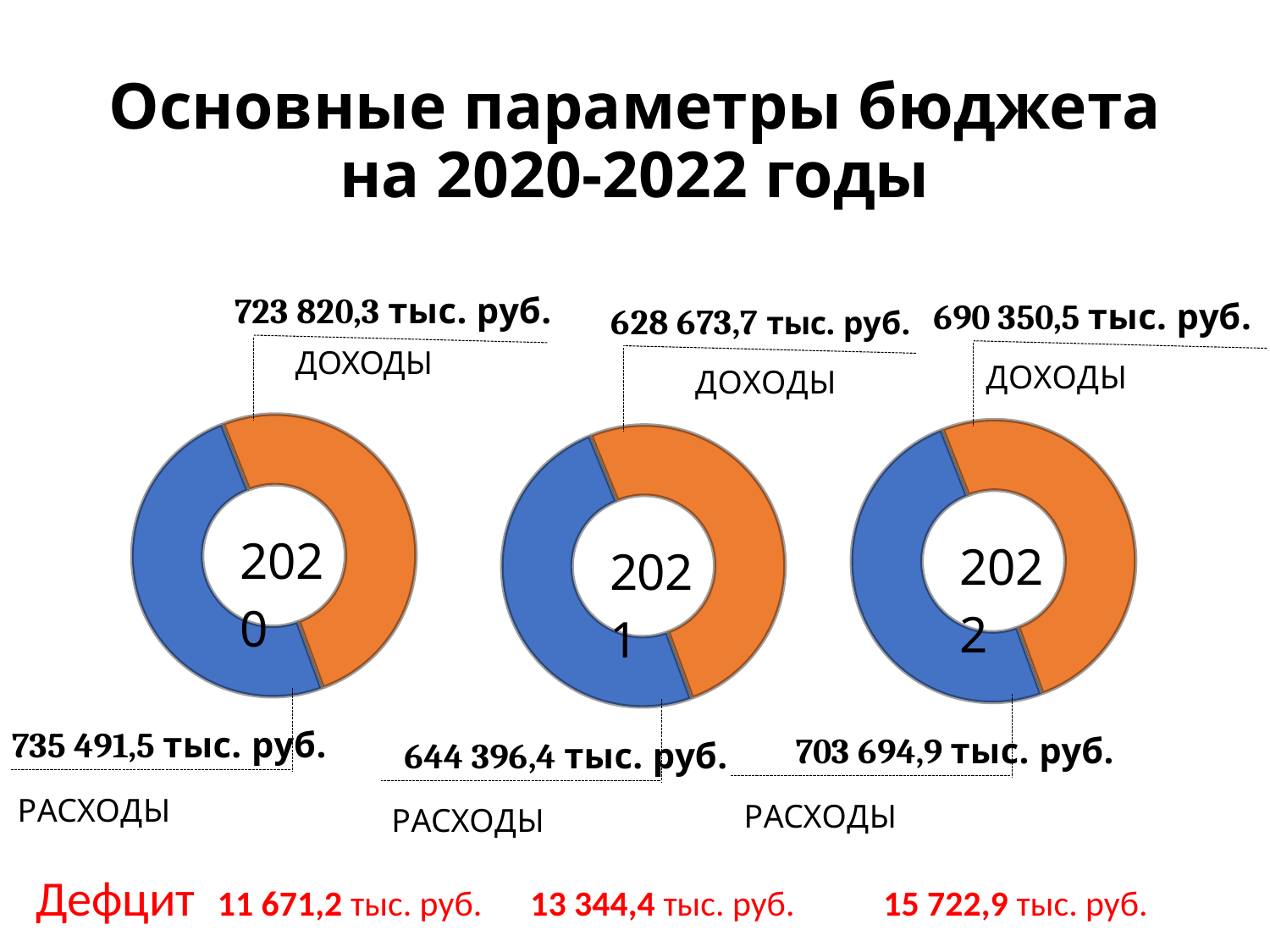
In the 2020 doughnut chart, which is larger, ДОХОДЫ or РАСХОДЫ? РАСХОДЫ What type of chart is used for each year on the slide? Doughnut chart How many doughnut charts are shown on the slide? 3 In the 2020 doughnut chart, what is the value for РАСХОДЫ? 735 491,5 тыс. руб. In the 2021 doughnut chart, which colour represents ДОХОДЫ? Orange In the 2022 doughnut chart, what is the value for РАСХОДЫ? 703 694,9 тыс. руб. In the 2020 doughnut chart, what is the value for ДОХОДЫ? 723 820,3 тыс. руб. In the 2022 doughnut chart, what is the difference between РАСХОДЫ and ДОХОДЫ? 13 344,4 тыс. руб. In the 2021 doughnut chart, what is the value for РАСХОДЫ? 644 396,4 тыс. руб. In the 2021 doughnut chart, what is the difference between РАСХОДЫ and ДОХОДЫ? 15 722,7 тыс. руб. In the 2021 doughnut chart, what is the value for ДОХОДЫ? 628 673,7 тыс. руб. In the 2022 doughnut chart, what is the value for ДОХОДЫ? 690 350,5 тыс. руб.